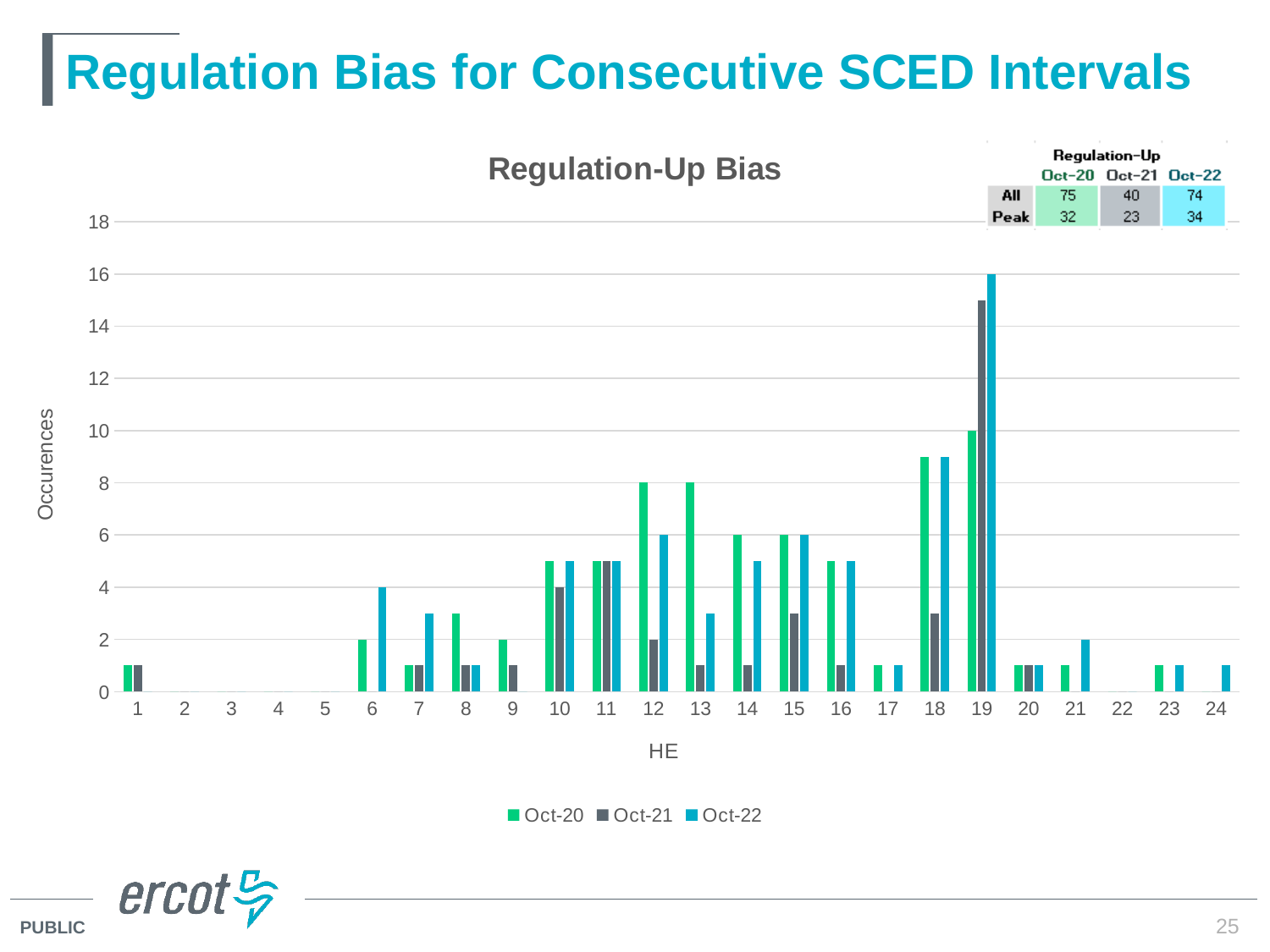
What is the Oct-22 value at HE 19? 16 At HE 19, how much larger is the Oct-22 value than the Oct-20 value? 6 What is the Oct-20 value at HE 19? 10 How many series does the legend list? 3 What is the title of the chart? Regulation-Up Bias How many HE categories are shown on the x axis? 24 What is the Oct-20 value at HE 12? 8 What kind of chart is shown on the slide? bar chart At HE 13, which series has the larger value, Oct-20 or Oct-22? Oct-20 Is the Oct-20 value at HE 18 greater or less than 8? greater Which HE has the highest Oct-22 value? 19 Is the Oct-21 value at HE 19 greater or less than 14? greater